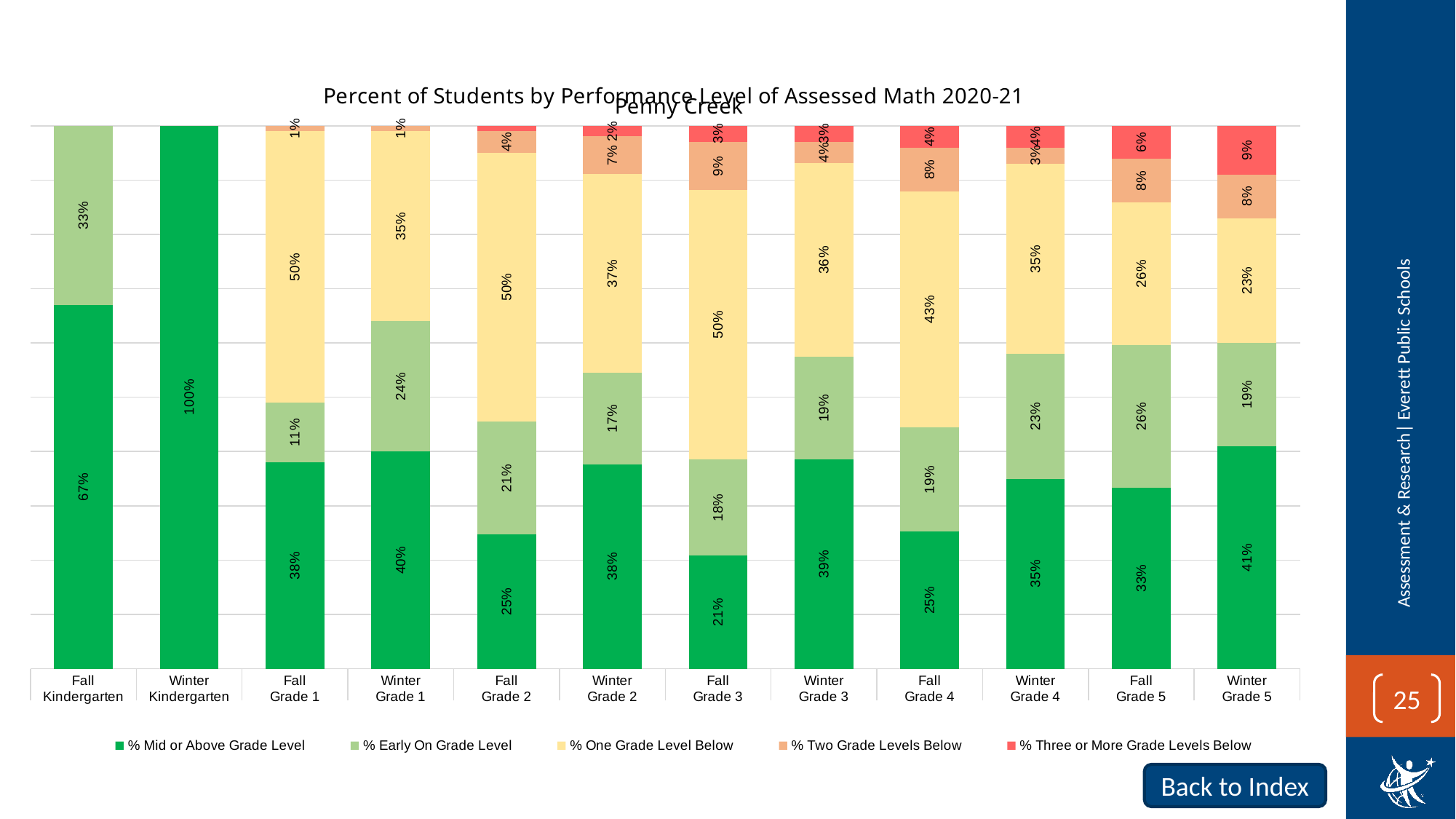
Which has a larger percentage of students One Grade Level Below: Fall Grade 2 or Winter Grade 2? Fall Grade 2 What is the difference in the percentage of students Mid or Above Grade Level between Winter Grade 3 and Fall Grade 3? 18% How many series does the legend list? 5 What percentage of students were Early On Grade Level in Winter Grade 1? 24% Which category has the lowest percentage of students Mid or Above Grade Level? Fall Grade 3 What percentage of students were One Grade Level Below in Fall Grade 4? 43% What kind of chart is shown on the slide? Stacked bar chart How many categories are shown on the x axis? 12 What is the total of the stacked bar for Fall Grade 1? 100% What percentage of students were Three or More Grade Levels Below in Winter Grade 5? 9% What percentage of students were Mid or Above Grade Level in Winter Grade 5? 41% Which category has the highest percentage of students Mid or Above Grade Level? Winter Kindergarten